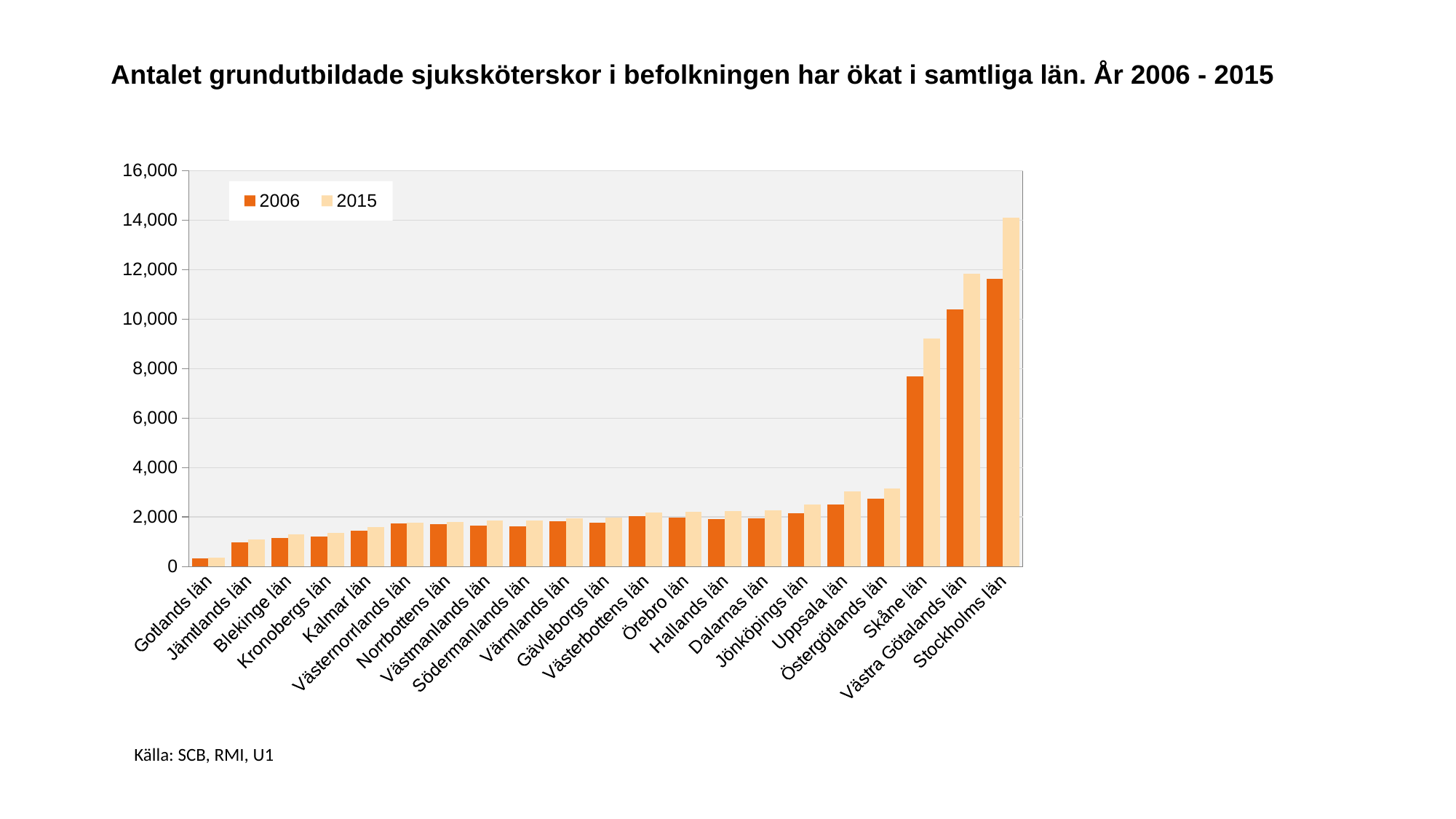
Which county has the lowest value for 2006? Gotlands län Is the 2015 value for Gotlands län greater or less than 2,000? less Which is larger: the 2015 value for Skåne län or the 2006 value for Västra Götalands län? the 2006 value for Västra Götalands län Is the 2006 value for Stockholms län greater or less than 10,000? greater Do the values generally rise or fall moving from left to right along the x axis? rise How many series does the legend list? 2 What kind of chart is shown on the slide? bar chart Which two years are shown in the legend? 2006 and 2015 How many counties (län) are shown on the x axis? 21 Which county has the highest value for 2015? Stockholms län Is the 2015 value for Skåne län greater or less than 8,000? greater